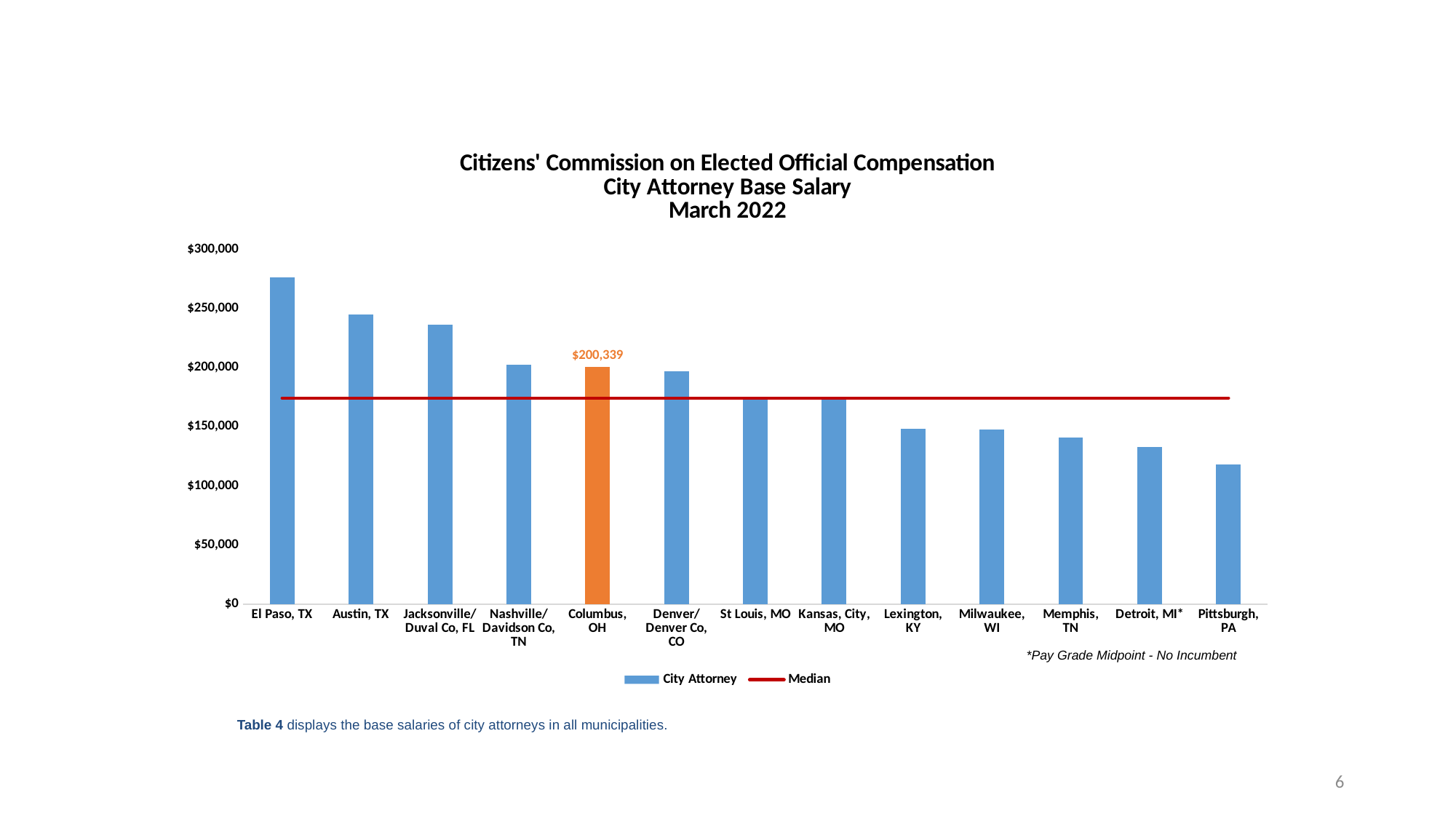
What kind of chart is used to show the city attorney base salaries? Bar chart Which municipality has the highest city attorney base salary? El Paso, TX Which has the larger city attorney base salary, Memphis, TN or Detroit, MI*? Memphis, TN Which municipality has the lowest city attorney base salary? Pittsburgh, PA Do the city attorney base salaries rise or fall from left to right across the chart? Fall Which municipality's bar is highlighted in orange on the chart? Columbus, OH How many municipalities are shown on the x axis of the chart? 13 Is the value for El Paso, TX greater or less than $250,000? greater Is the value for Jacksonville/Duval Co, FL greater or less than $200,000? greater Is the value for Pittsburgh, PA greater or less than $150,000? less How many entries does the chart legend list? 2 What is the city attorney base salary shown for Columbus, OH? $200,339